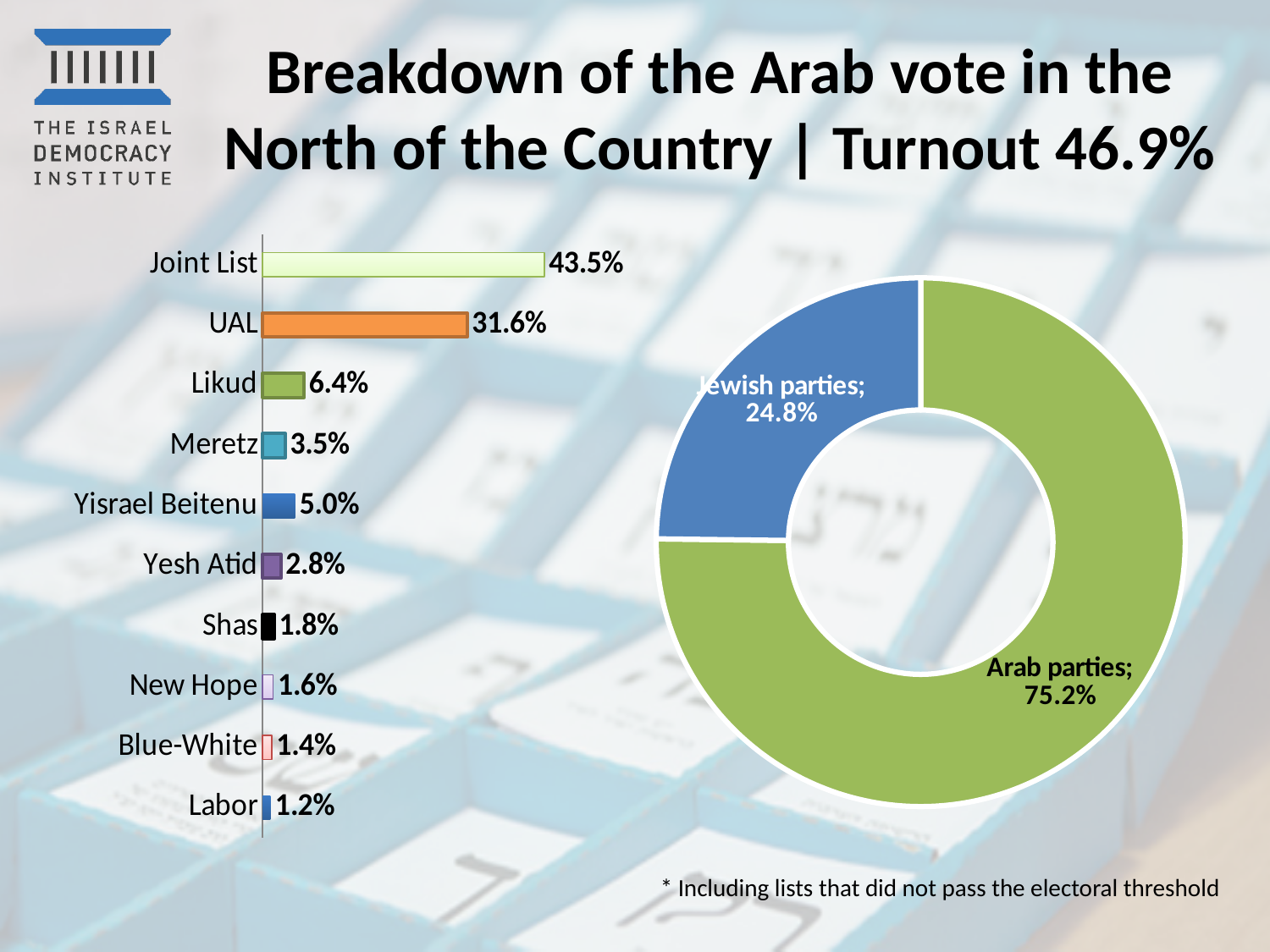
How many parties are shown in the bar chart on the left? 10 In the doughnut chart on the right, what is the share for Jewish parties? 24.8% In the bar chart on the left, what is the value for Joint List? 43.5% In the doughnut chart on the right, which segment is larger, Arab parties or Jewish parties? Arab parties In the bar chart on the left, what is the value for Yisrael Beitenu? 5.0% In the doughnut chart on the right, what is the share for Arab parties? 75.2% In the bar chart on the left, which is larger, the value for Likud or the value for Meretz? Likud In the bar chart on the left, which party has the highest value? Joint List In the bar chart on the left, what is the difference between the values for Joint List and UAL? 11.9% In the bar chart on the left, which party has the lowest value? Labor What kind of chart is on the left side of the slide? Bar chart What turnout figure is given in the slide title? 46.9%